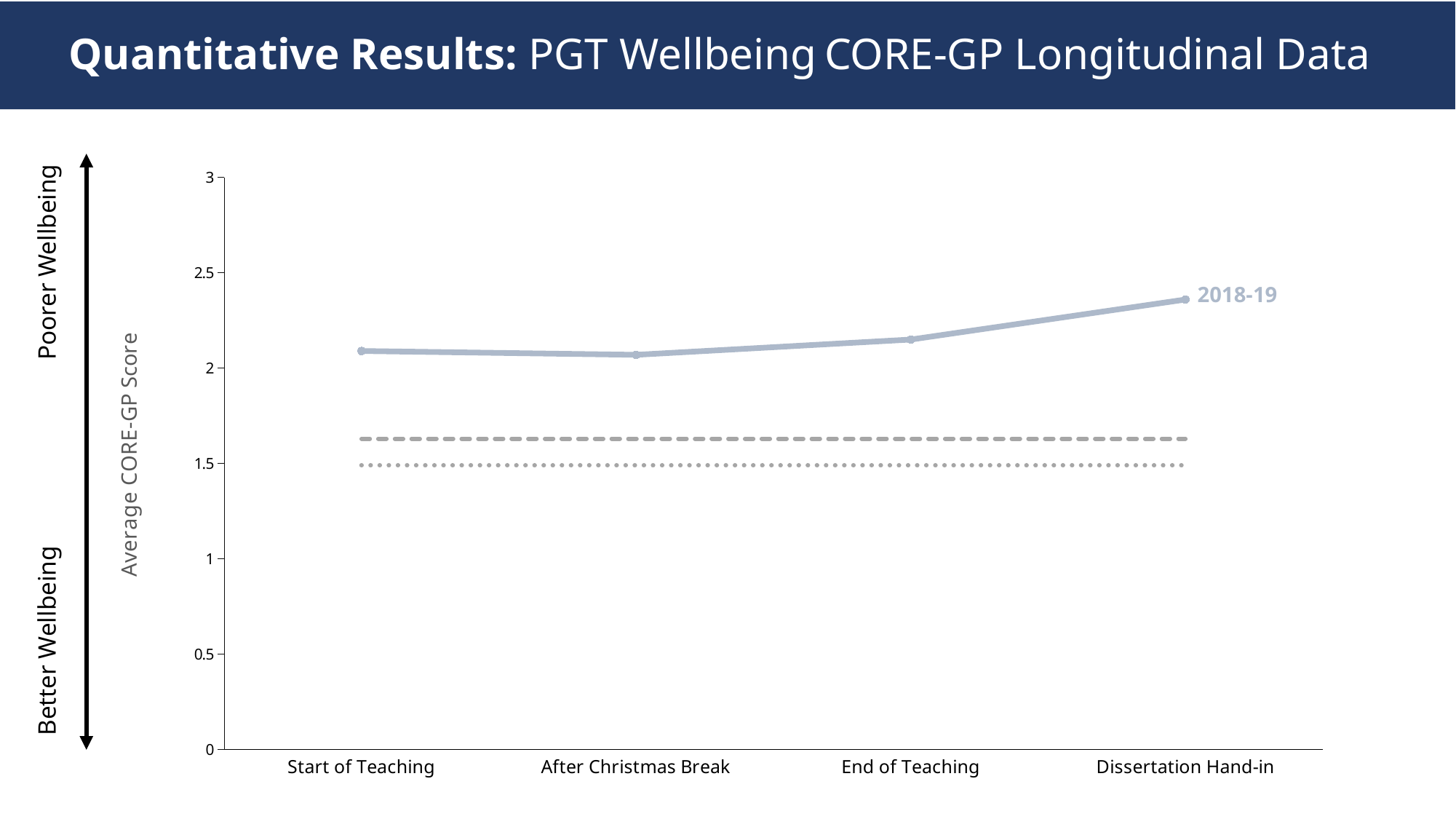
Is the 2018-19 value at Dissertation Hand-in greater or less than 2? greater What kind of chart is shown on the slide? line chart Which is larger for 2018-19: the value at After Christmas Break or at Dissertation Hand-in? Dissertation Hand-in Does the 2018-19 line rise or fall between End of Teaching and Dissertation Hand-in? rise What label is attached to the plotted solid line? 2018-19 Which is larger for 2018-19: the value at End of Teaching or at Dissertation Hand-in? Dissertation Hand-in Is the dashed horizontal reference line greater or less than 2? less At which time point is the 2018-19 average CORE-GP score highest? Dissertation Hand-in Is the 2018-19 value at Dissertation Hand-in greater or less than 2.5? less How many time points are plotted along the x axis? 4 What is the label on the y axis? Average CORE-GP Score